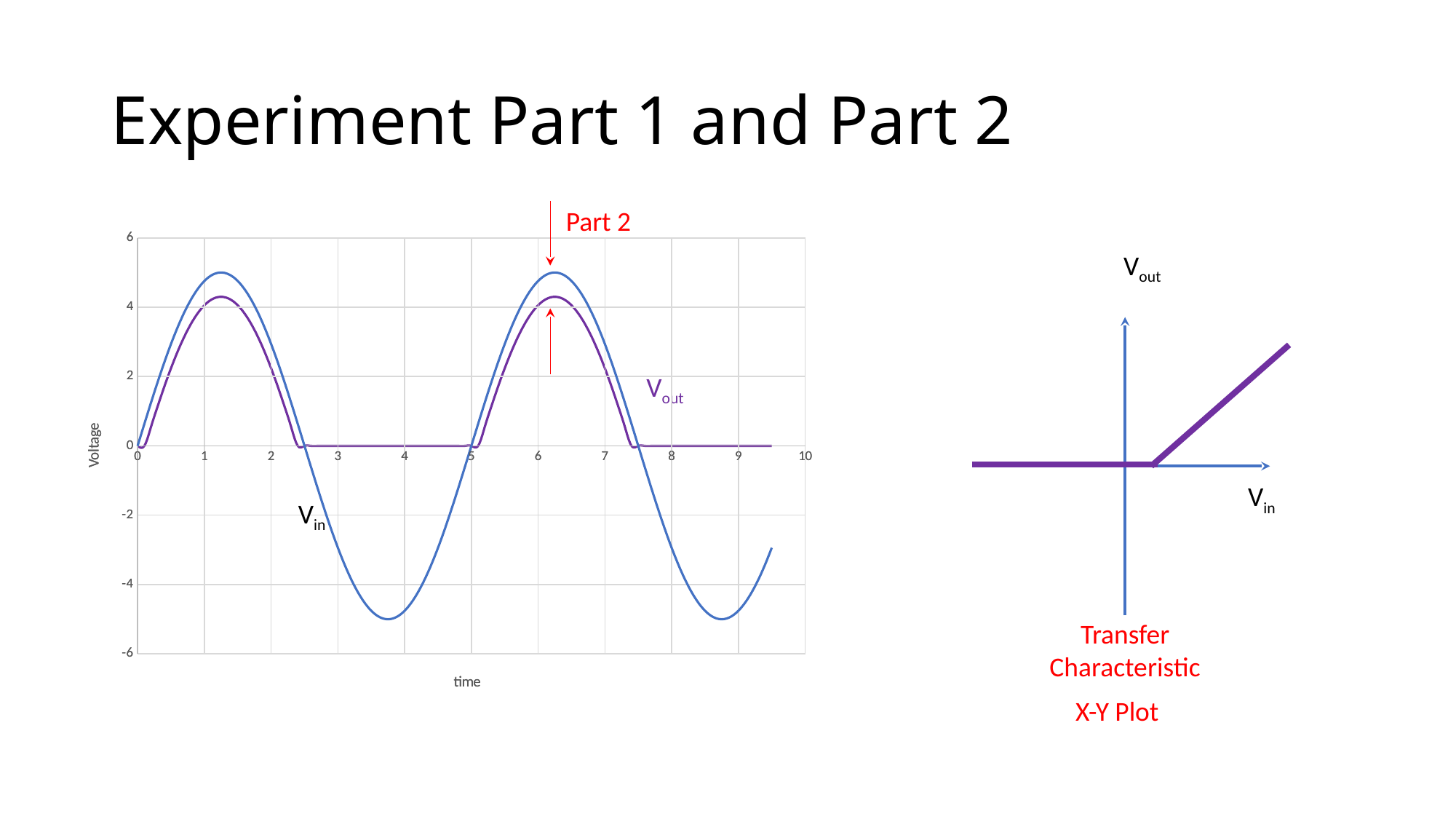
What kind of chart is the left chart plotting Voltage against time? line chart On the left chart, is the peak value of Vin greater or less than 4? greater On the left chart, is the minimum value of Vin greater or less than -4? less What is the title written in red below the right-hand plot? Transfer Characteristic X-Y Plot On the left chart, what is the value of Vout between time 3 and time 4? 0 What is the x-axis label of the left chart? time On the left chart, is the peak value of Vout greater or less than 6? less On the left chart, which series reaches the higher peak voltage, Vin or Vout? Vin On the left chart, which series goes below 0 volts? Vin On the left chart, how many series are plotted? 2 On the left chart, does Vin rise or fall between time 0 and time 1? rise